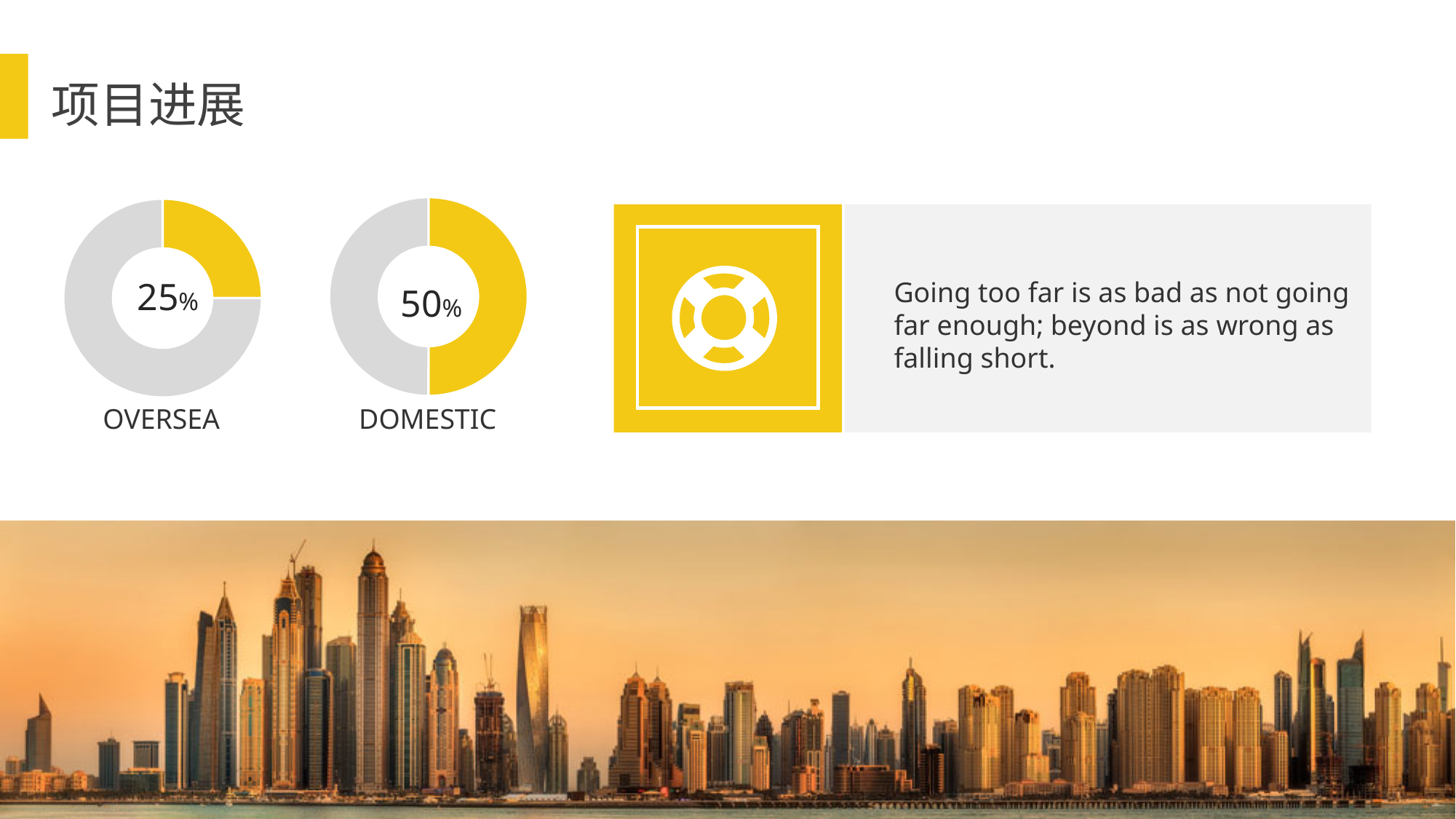
In the DOMESTIC donut chart, what share of the ring is filled in yellow? 50% What percentage is shown in the DOMESTIC donut chart? 50% How many donut charts are shown on the slide? 2 Which donut chart shows the lowest percentage? OVERSEA What is the difference between the DOMESTIC percentage and the OVERSEA percentage? 25% What percentage is shown in the OVERSEA donut chart? 25% Which of the two donut charts shows the higher percentage, OVERSEA or DOMESTIC? DOMESTIC In the OVERSEA donut chart, what share of the ring is filled in yellow? 25% What type of chart is used to show the OVERSEA and DOMESTIC values? Donut chart What colour is used for the filled portion of the donut charts? Yellow What is the label under the left donut chart? OVERSEA